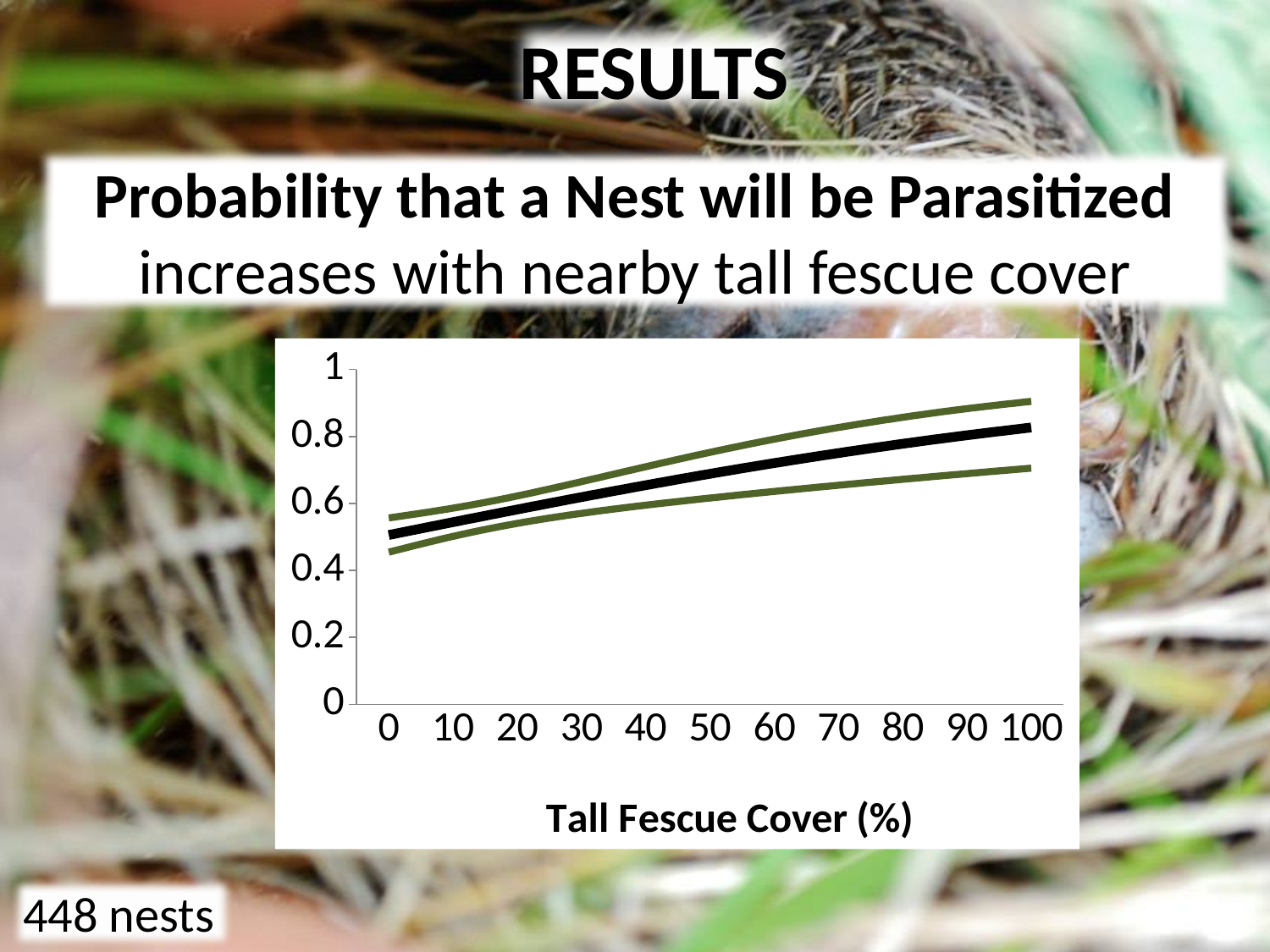
What is the highest value shown on the y axis? 1 Is the value of the black line at 100% Tall Fescue Cover greater or less than 0.6? greater Does the black line rise or fall as Tall Fescue Cover increases from 0 to 100? rises Is the value of the black line at 50% Tall Fescue Cover greater or less than 0.6? greater How many lines are plotted on the chart? 3 Is the value of the lower green line at 100% Tall Fescue Cover greater or less than 0.8? less What kind of chart is shown on the slide? line chart What is the title of the x axis? Tall Fescue Cover (%) Is the black line higher at 100% Tall Fescue Cover or at 0% Tall Fescue Cover? 100% How many tick labels are shown on the x axis? 11